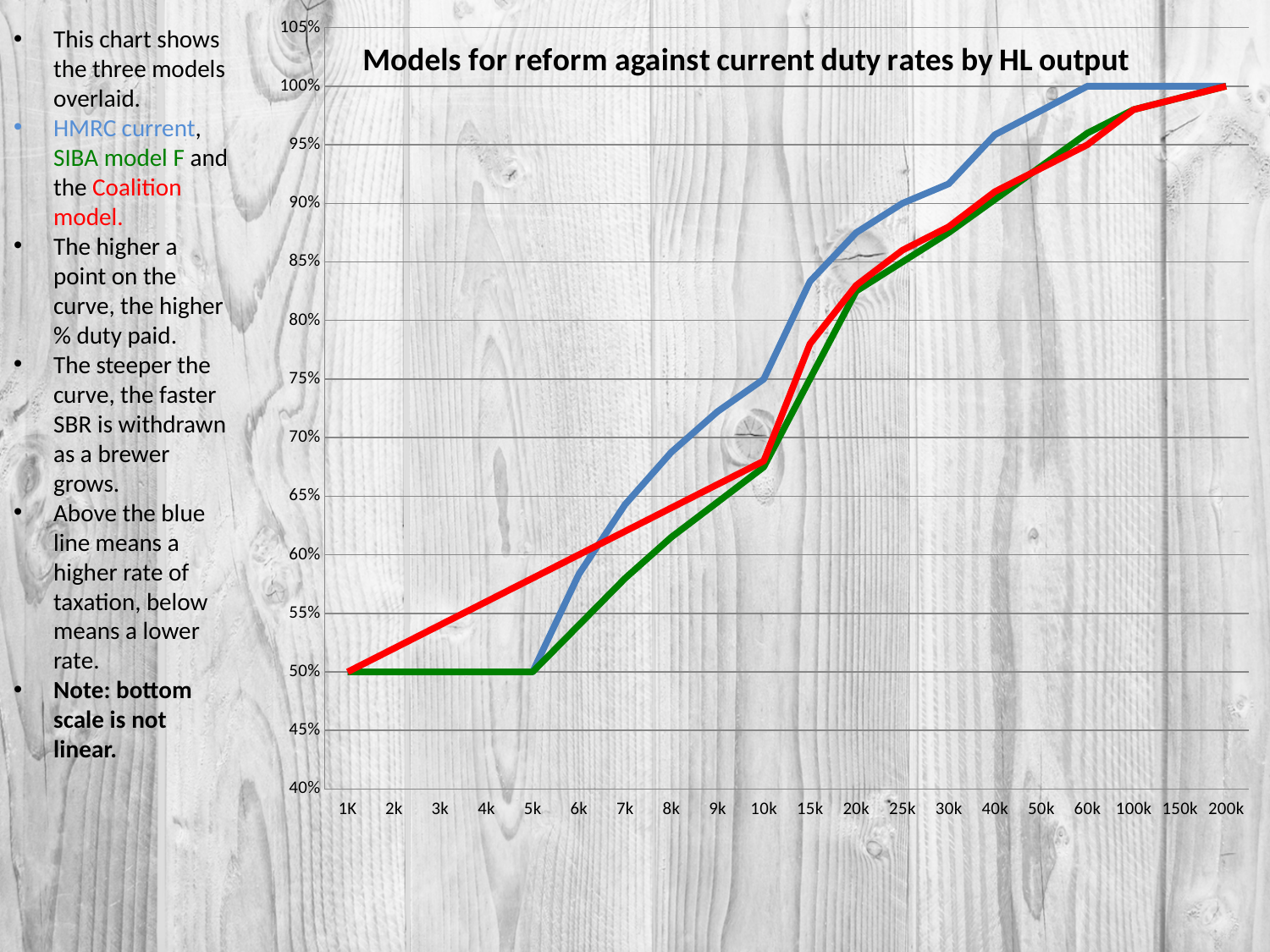
Is the value of the red Coalition model line at 10k greater or less than 70%? less What is the value of the red Coalition model line at 1K? 50% How many categories are shown on the x axis of the chart? 20 What is the value of the green SIBA model F line at 5k? 50% What value do all three lines reach at 200k? 100% Is the value of the red Coalition model line at 30k greater or less than 90%? less What is the title of the chart? Models for reform against current duty rates by HL output At 3k, which line is higher: the red Coalition model or the green SIBA model F? red Coalition model How many lines are plotted on the chart? 3 Is the value of the blue HMRC current line at 15k greater or less than 80%? greater What kind of chart is shown on the slide? line chart Do the lines generally rise or fall as output increases along the x axis? rise